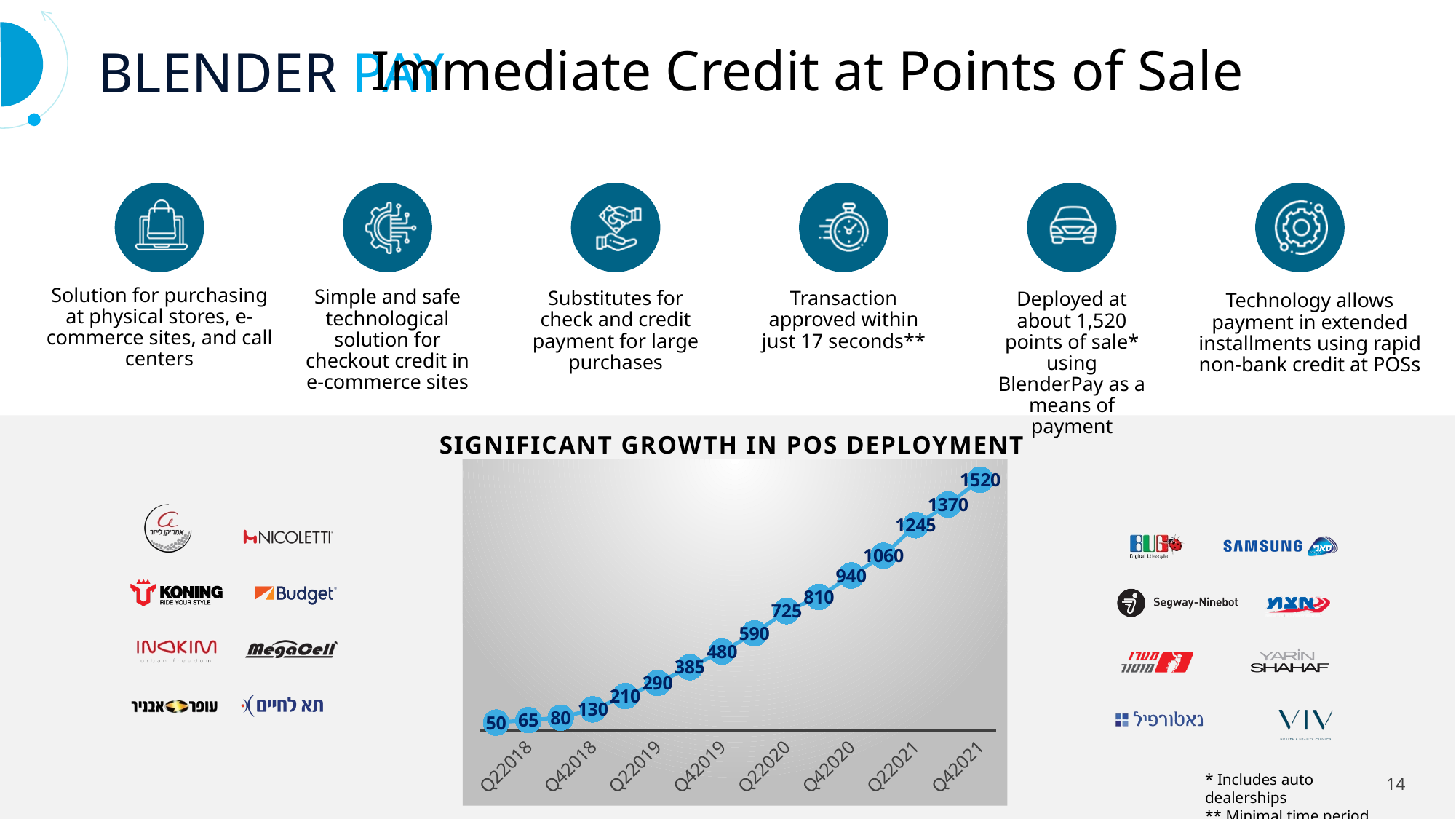
What is the first label on the x axis of the POS deployment chart? Q22018 What is the lowest value plotted on the POS deployment chart? 50 What type of chart is shown under the heading 'SIGNIFICANT GROWTH IN POS DEPLOYMENT'? line chart What is the difference between the last two data points (1370 and 1520) on the POS deployment chart? 150 What is the title of the chart on the slide? SIGNIFICANT GROWTH IN POS DEPLOYMENT What is the highest value plotted on the POS deployment chart? 1520 Which is larger on the POS deployment chart: the first data point or the last data point? the last data point What is the difference between the highest and lowest values on the POS deployment chart? 1470 Do the values on the POS deployment chart rise or fall from left to right? rise How many labels are shown on the x axis of the POS deployment chart? 8 How many data points are plotted on the POS deployment chart? 16